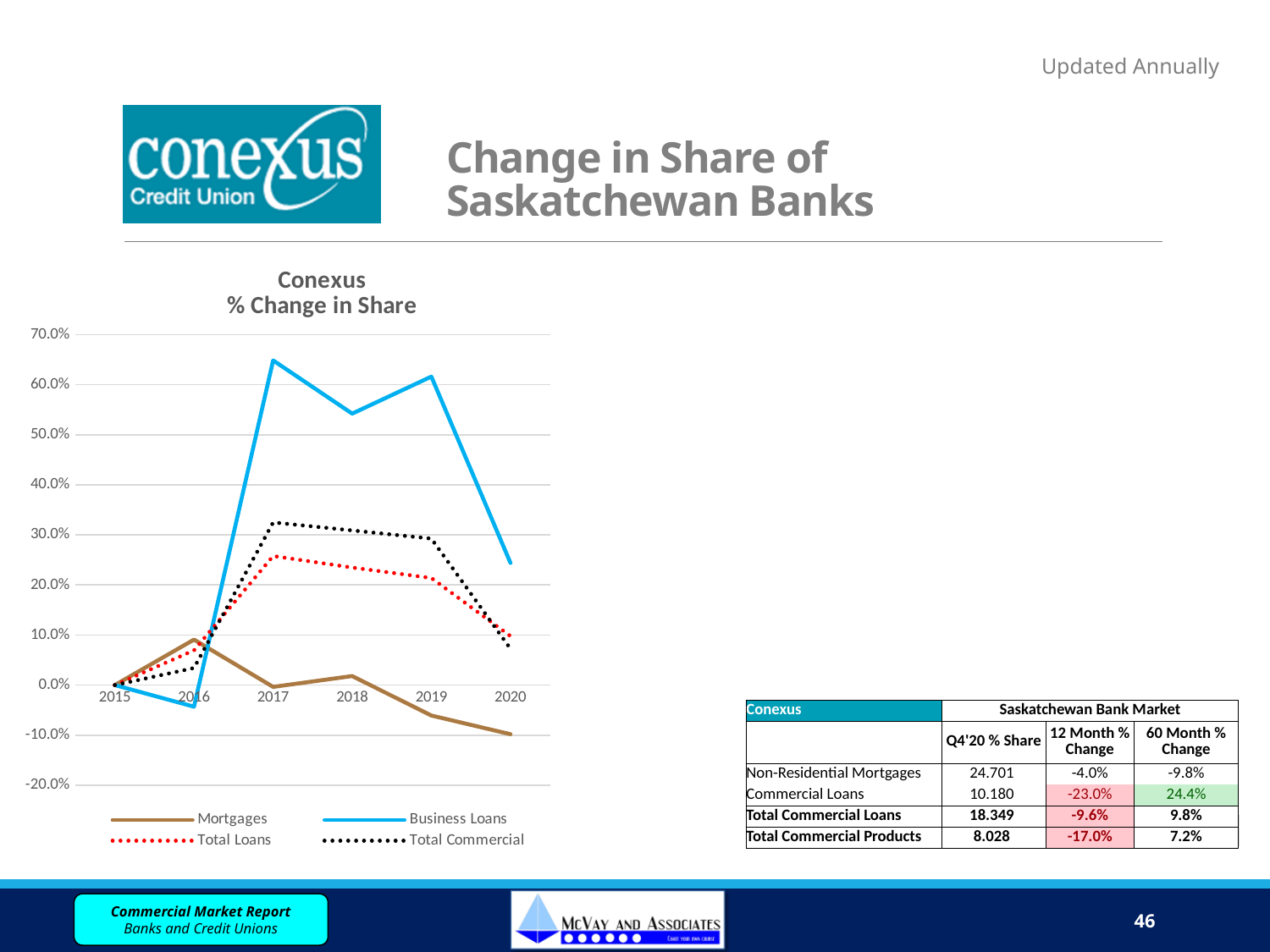
How many years are shown on the x axis of the 'Conexus % Change in Share' chart? 6 Does the Business Loans line rise or fall from 2019 to 2020? fall Is the value for Business Loans in 2016 greater or less than 0.0%? less In which year does the Mortgages line reach its highest value? 2016 In 2018, which is larger: Business Loans or Mortgages? Business Loans Which series in the 'Conexus % Change in Share' chart is drawn as a solid blue line? Business Loans How many series does the legend of the 'Conexus % Change in Share' chart list? 4 In 2019, which is larger: Total Commercial or Total Loans? Total Commercial Is the value for Total Commercial in 2017 greater or less than 30.0%? greater Is the value for Business Loans in 2017 greater or less than 60.0%? greater In which year does the Business Loans line reach its highest value? 2017 What kind of chart is the 'Conexus % Change in Share' chart? line chart